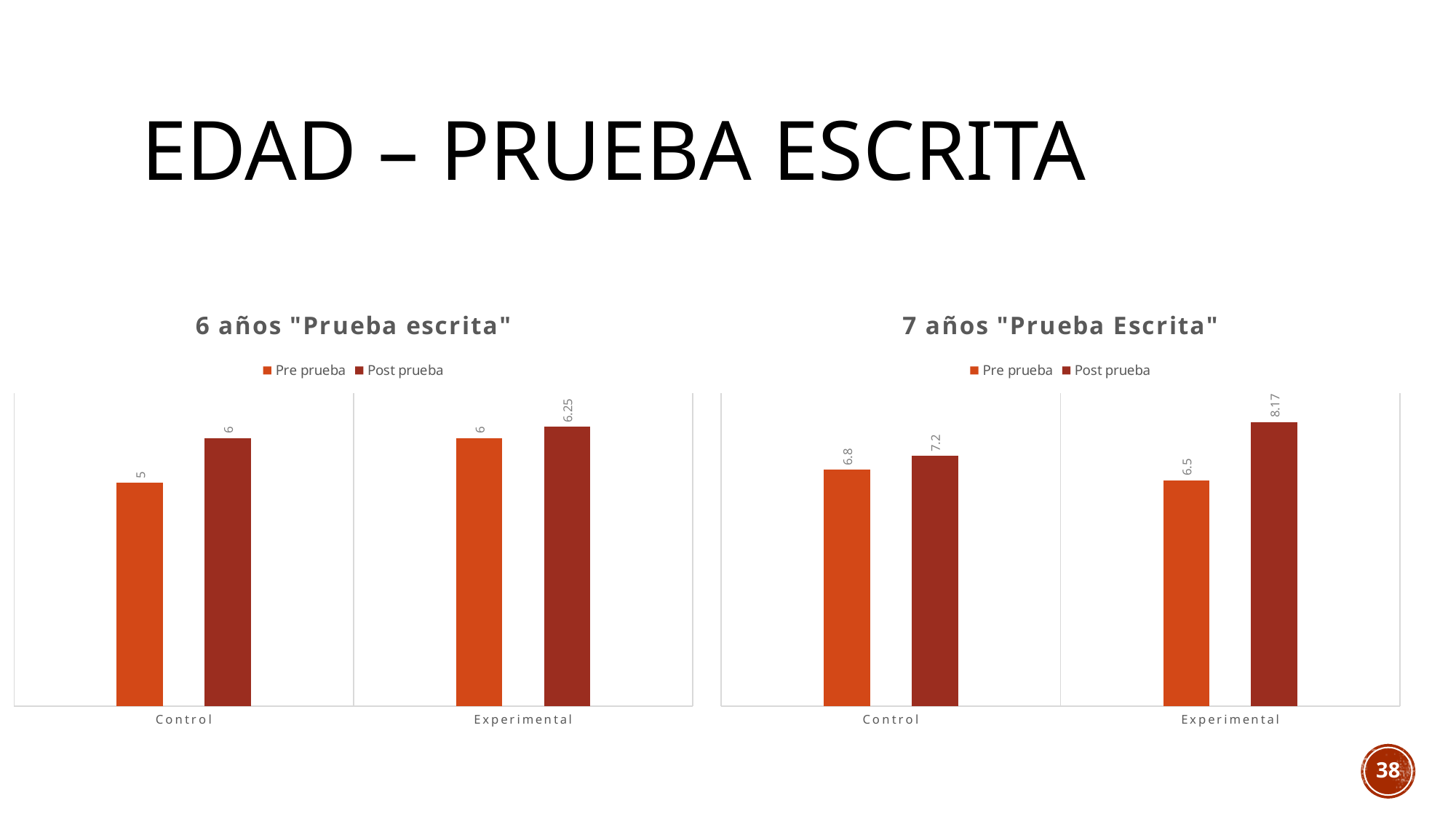
In the chart titled 6 años "Prueba escrita", which bar has the lowest value? Pre prueba for Control In the chart titled 7 años "Prueba Escrita", which is larger: the Pre prueba value for Control or the Pre prueba value for Experimental? Pre prueba for Control How many series does the legend list in the chart titled 7 años "Prueba Escrita"? 2 In the chart titled 7 años "Prueba Escrita", what is the Post prueba value for Control? 7.2 In the chart titled 7 años "Prueba Escrita", what is the difference between the Post prueba and Pre prueba values for Experimental? 1.67 In the chart titled 6 años "Prueba escrita", what is the Post prueba value for Experimental? 6.25 What kind of chart is the chart titled 6 años "Prueba escrita"? Bar chart In the chart titled 6 años "Prueba escrita", what is the Pre prueba value for Control? 5 In the chart titled 7 años "Prueba Escrita", what is the Pre prueba value for Experimental? 6.5 How many categories are shown on the x axis of the chart titled 6 años "Prueba escrita"? 2 In the chart titled 6 años "Prueba escrita", what is the difference between the Post prueba and Pre prueba values for Control? 1 In the chart titled 7 años "Prueba Escrita", which bar has the highest value? Post prueba for Experimental